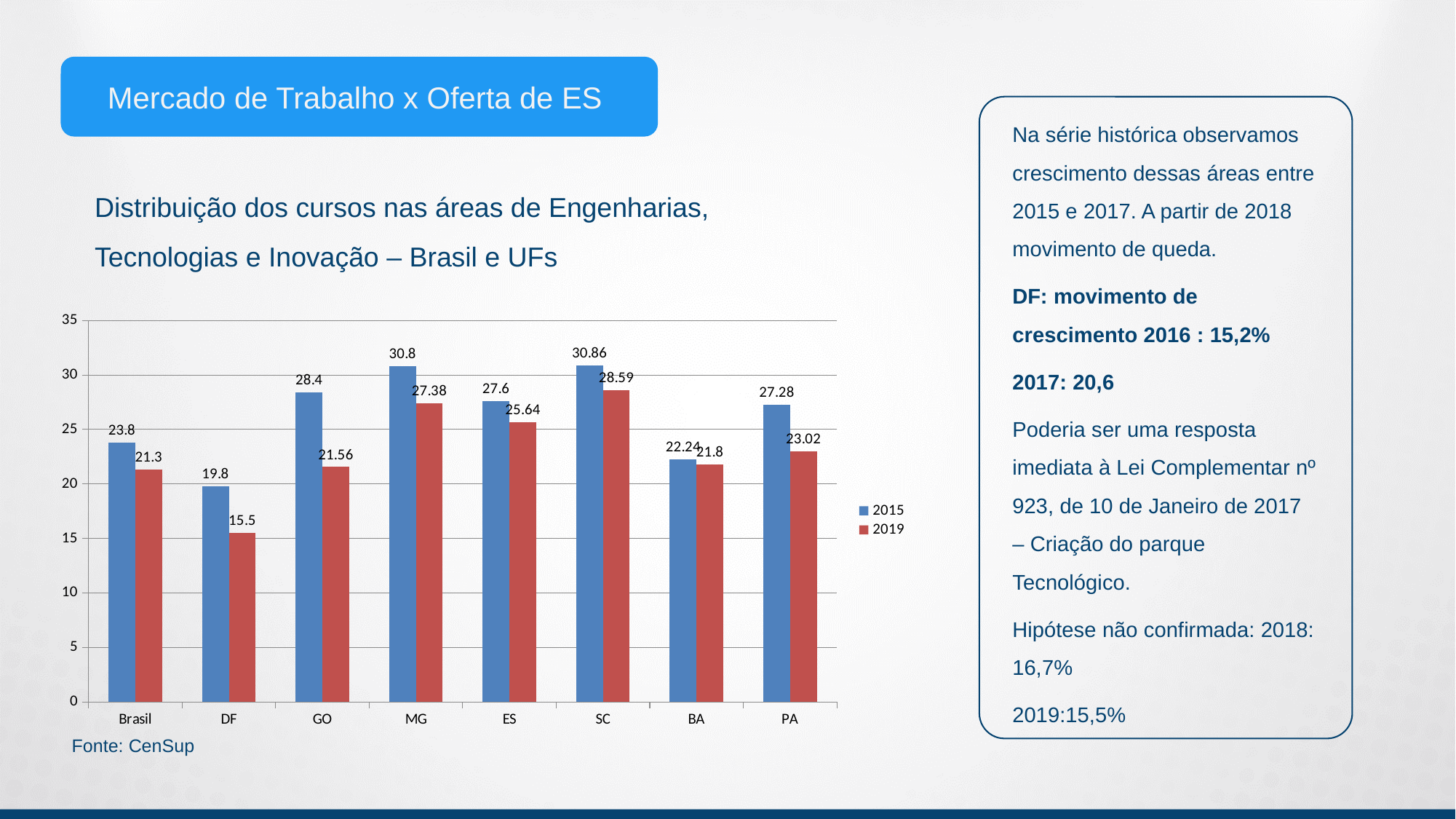
How many series does the legend list? 2 Which category has the lowest value in the 2019 series? DF Which category has the highest value in the 2019 series? SC What kind of chart is shown on the slide? bar chart What is the value for GO in the 2019 series? 21.56 What is the value for Brasil in the 2015 series? 23.8 What is the difference between the 2015 and 2019 values for GO? 6.84 How many categories are shown on the x axis? 8 What is the value for SC in the 2015 series? 30.86 Which is larger: the 2015 value for Brasil or the 2015 value for PA? PA What is the difference between the 2015 and 2019 values for DF? 4.3 Is the 2019 value for DF greater or less than 20? less